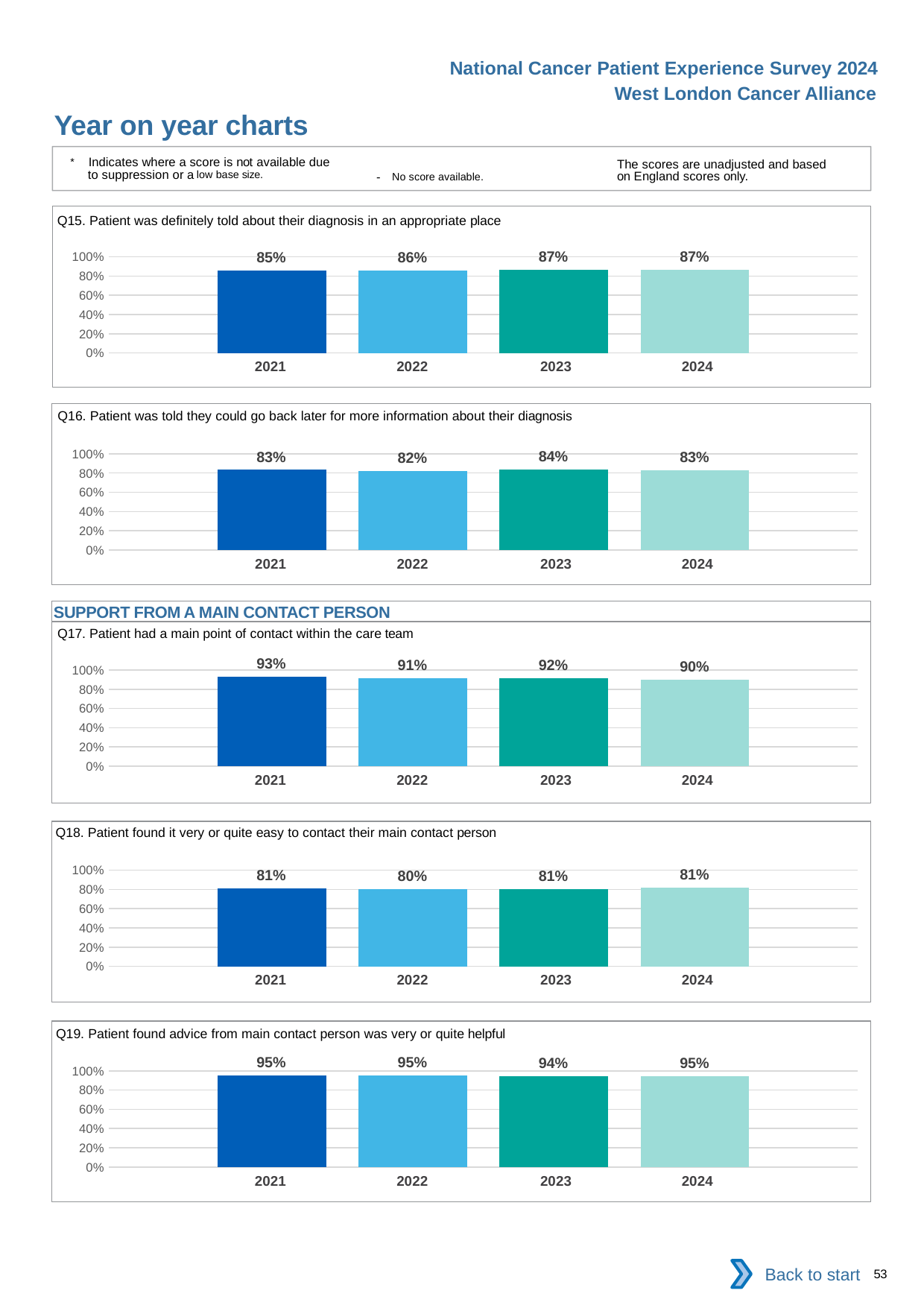
In the Q18 chart, what is the value for 2022? 80% In the Q17 chart, which year has the lowest value? 2024 In the Q15 chart, is the value for 2022 larger than the value for 2021? Yes In the Q19 chart, what is the value for 2024? 95% What is the section heading shown above the Q17 chart? SUPPORT FROM A MAIN CONTACT PERSON In the Q15 chart, what is the value for 2021? 85% What kind of chart is the Q19 chart? Bar chart In the Q15 chart, do the values rise or fall from 2021 to 2024? Rise In the Q17 chart, what is the difference between the 2021 and 2024 values? 3% In the Q19 chart, which year has the lowest value? 2023 In the Q16 chart, which year has the highest value? 2023 In the Q16 chart, how many years are plotted? 4